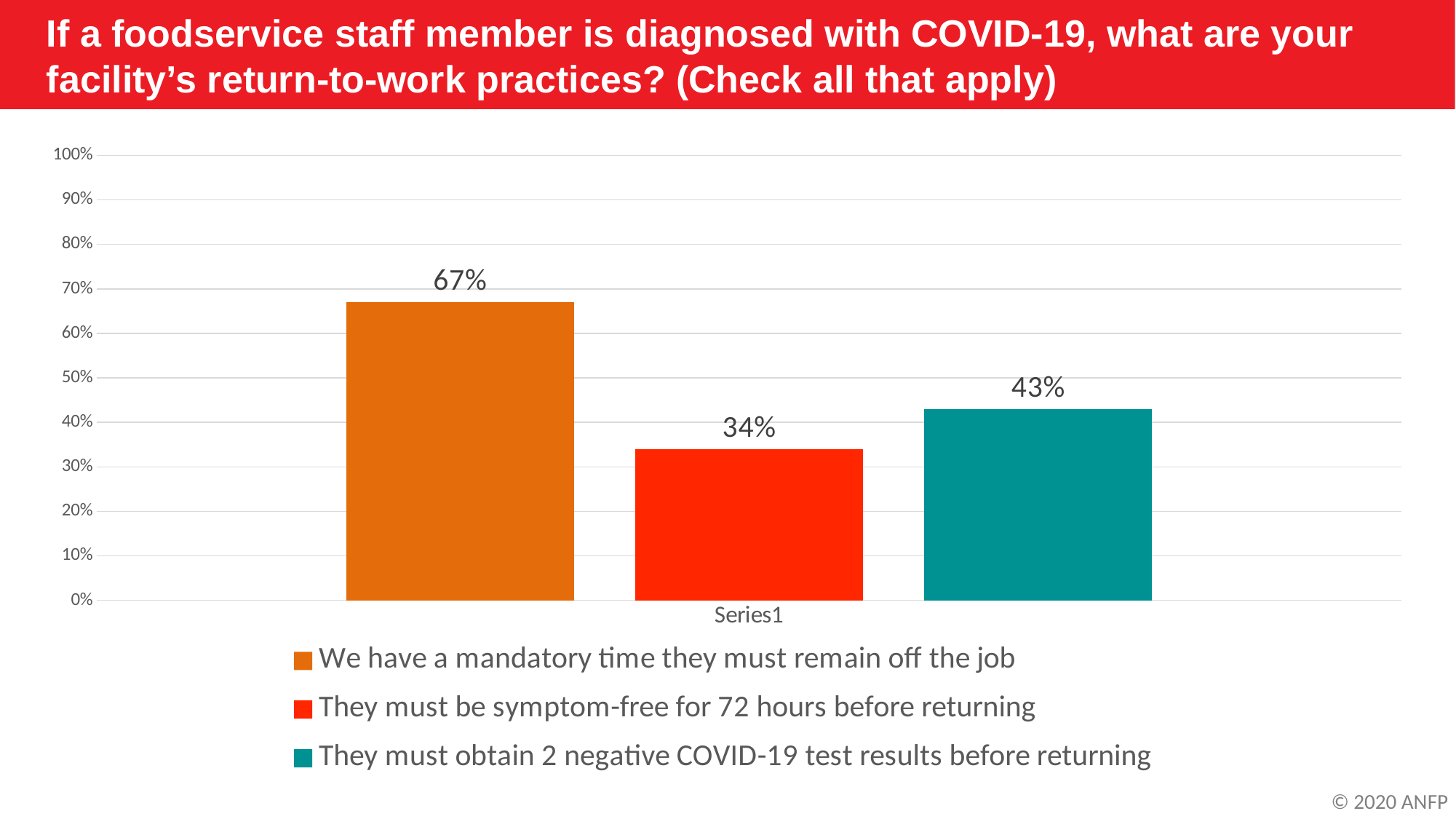
What percentage of respondents said they have a mandatory time staff must remain off the job? 67% What is the difference in percentage points between the 2 negative test results and the symptom-free for 72 hours practices? 9% How many return-to-work practices are plotted in the chart? 3 What percentage of respondents said staff must obtain 2 negative COVID-19 test results before returning? 43% Which is larger: the percentage for symptom-free for 72 hours or the percentage for 2 negative COVID-19 test results? They must obtain 2 negative COVID-19 test results before returning What is the difference in percentage points between the mandatory time off the job and the 2 negative test results practices? 24% Is the value for the mandatory time off the job practice greater or less than 60%? greater What kind of chart is shown on the slide? Bar chart What colour is the bar for the practice requiring 2 negative COVID-19 test results? Teal Which return-to-work practice has the lowest percentage? They must be symptom-free for 72 hours before returning What percentage of respondents said staff must be symptom-free for 72 hours before returning? 34% Which return-to-work practice has the highest percentage? We have a mandatory time they must remain off the job